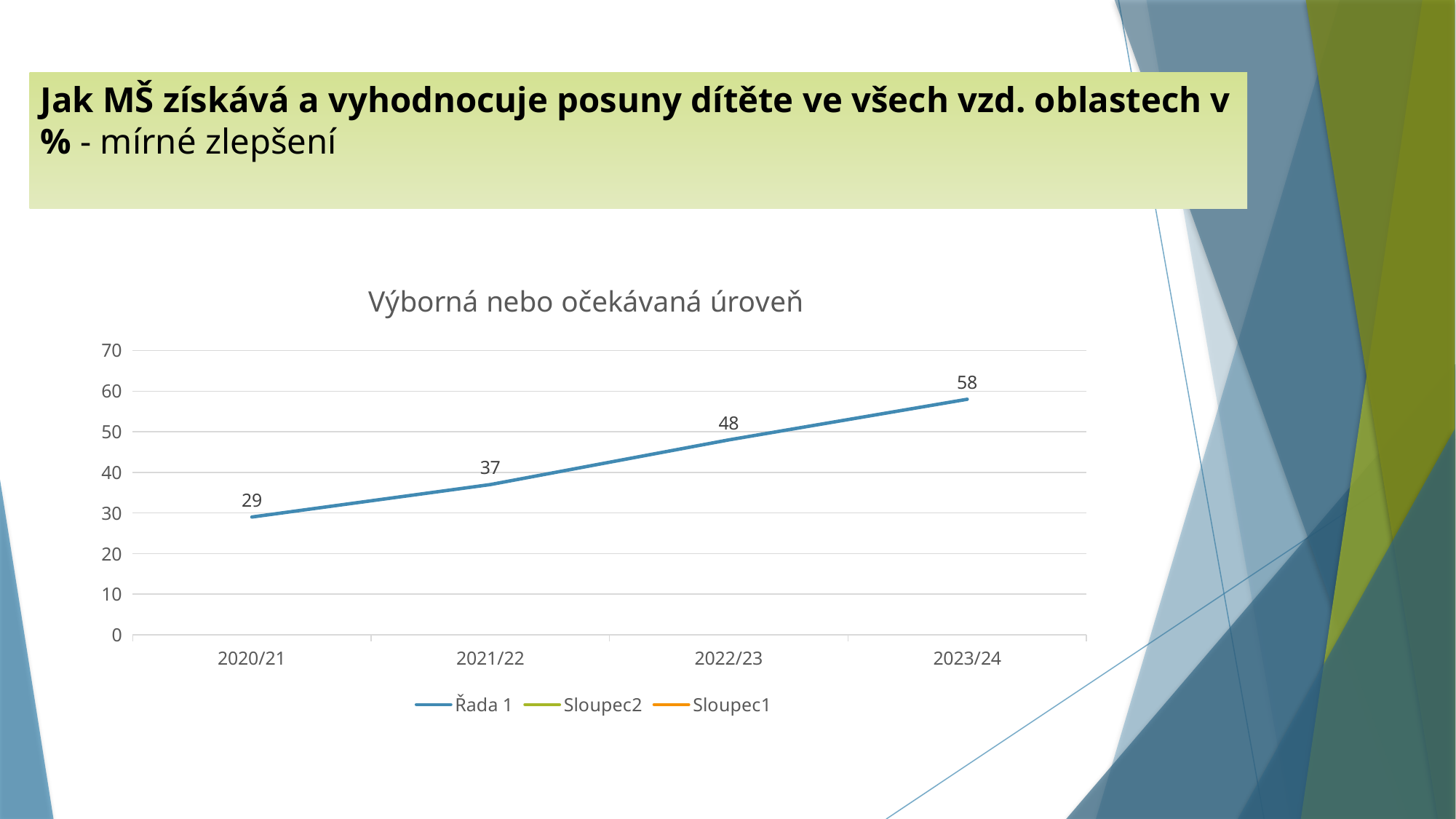
What is the value for 2021/22? 37 What is the difference between the values for 2023/24 and 2020/21? 29 What is the value for 2022/23? 48 What kind of chart is shown? line chart Do the values rise or fall from 2020/21 to 2023/24? rise Which year has the lowest value? 2020/21 How many series does the legend list? 3 Which year has the highest value? 2023/24 How many data points are plotted on the line? 4 What is the value for 2023/24? 58 What is the value for 2020/21? 29 Which is larger, the value for 2021/22 or the value for 2022/23? 2022/23